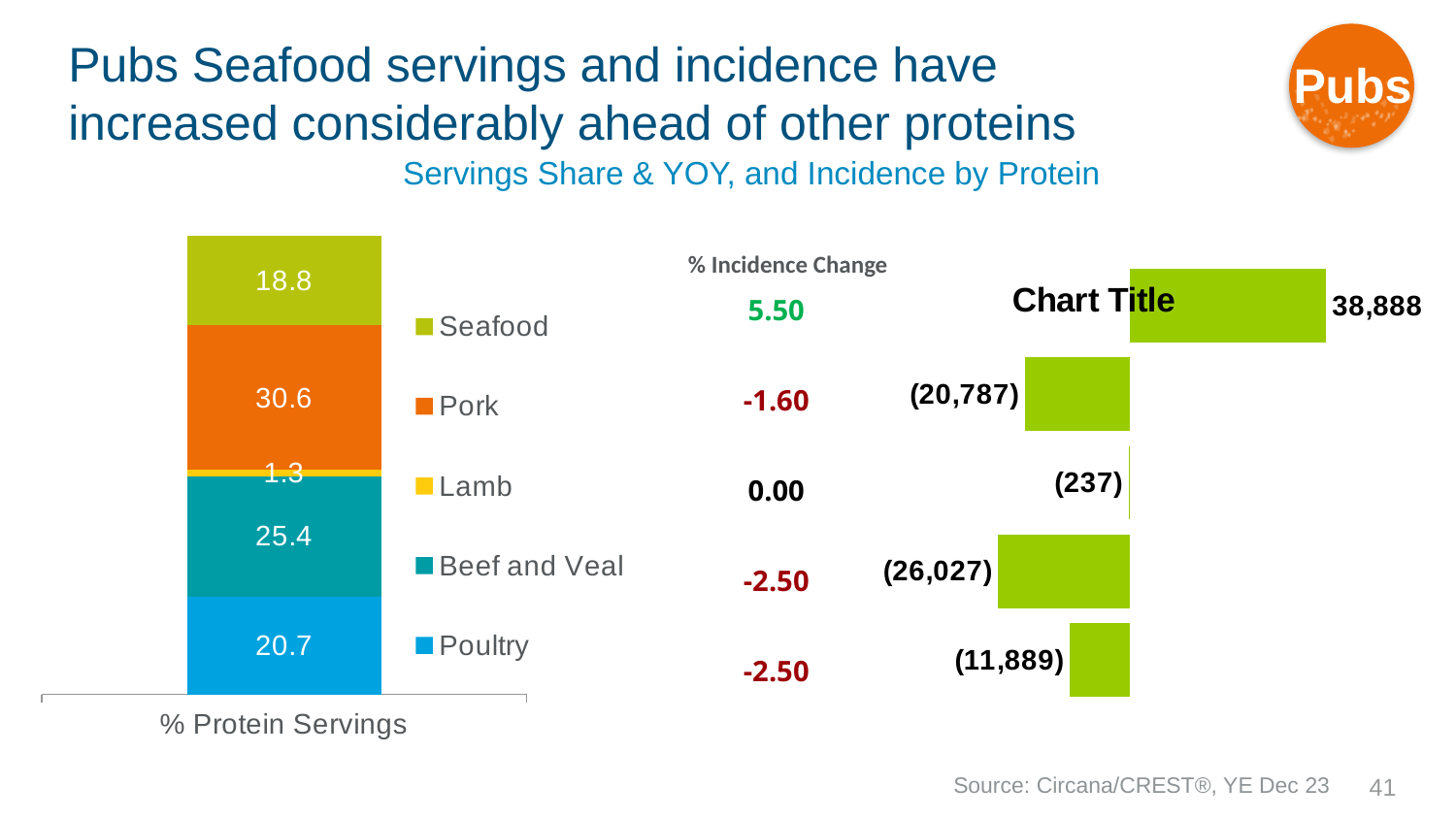
In the right-hand chart titled 'Chart Title', what value is shown for the bottom bar? (11,889) In the stacked bar chart on the left (% Protein Servings), what is the value for Seafood? 18.8 How many series does the legend of the stacked bar chart on the left list? 5 In the stacked bar chart on the left (% Protein Servings), which is larger, Beef and Veal or Poultry? Beef and Veal In the stacked bar chart on the left (% Protein Servings), which protein has the largest share? Pork In the stacked bar chart on the left (% Protein Servings), which protein has the smallest share? Lamb In the stacked bar chart on the left (% Protein Servings), what is the value for Lamb? 1.3 In the stacked bar chart on the left (% Protein Servings), what is the value for Pork? 30.6 What kind of chart is the chart on the left labelled % Protein Servings? Stacked bar chart In the stacked bar chart on the left (% Protein Servings), what is the total of all the segments? 96.8 In the right-hand chart titled 'Chart Title', what value is shown for the top bar? 38,888 In the stacked bar chart on the left (% Protein Servings), what is the difference between the Pork and Seafood values? 11.8